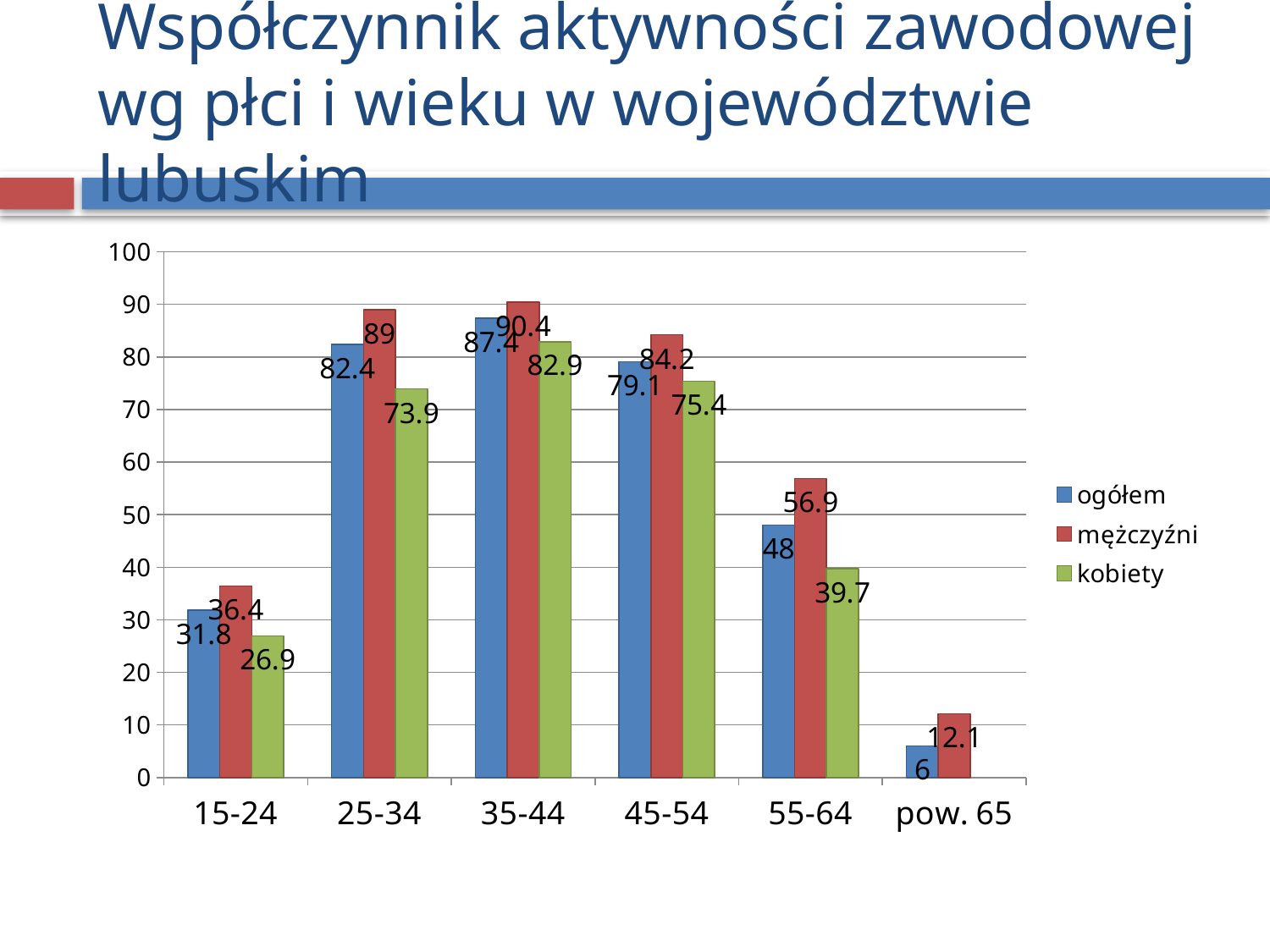
What is the value for ogółem in the 15-24 age group? 31.8 How many age groups are shown on the x axis? 6 Is the value for mężczyźni in the 55-64 age group greater or less than 50? greater Which age group has the lowest value for mężczyźni? pow. 65 What is the difference between the mężczyźni and kobiety values in the 25-34 age group? 15.1 What is the value for kobiety in the 55-64 age group? 39.7 Which colour represents the kobiety series in the legend? green How many series does the legend list? 3 What kind of chart is shown on the slide? bar chart Which age group has the highest value for ogółem? 35-44 What is the value for mężczyźni in the 35-44 age group? 90.4 Which is larger in the 45-54 age group: the value for ogółem or for kobiety? ogółem